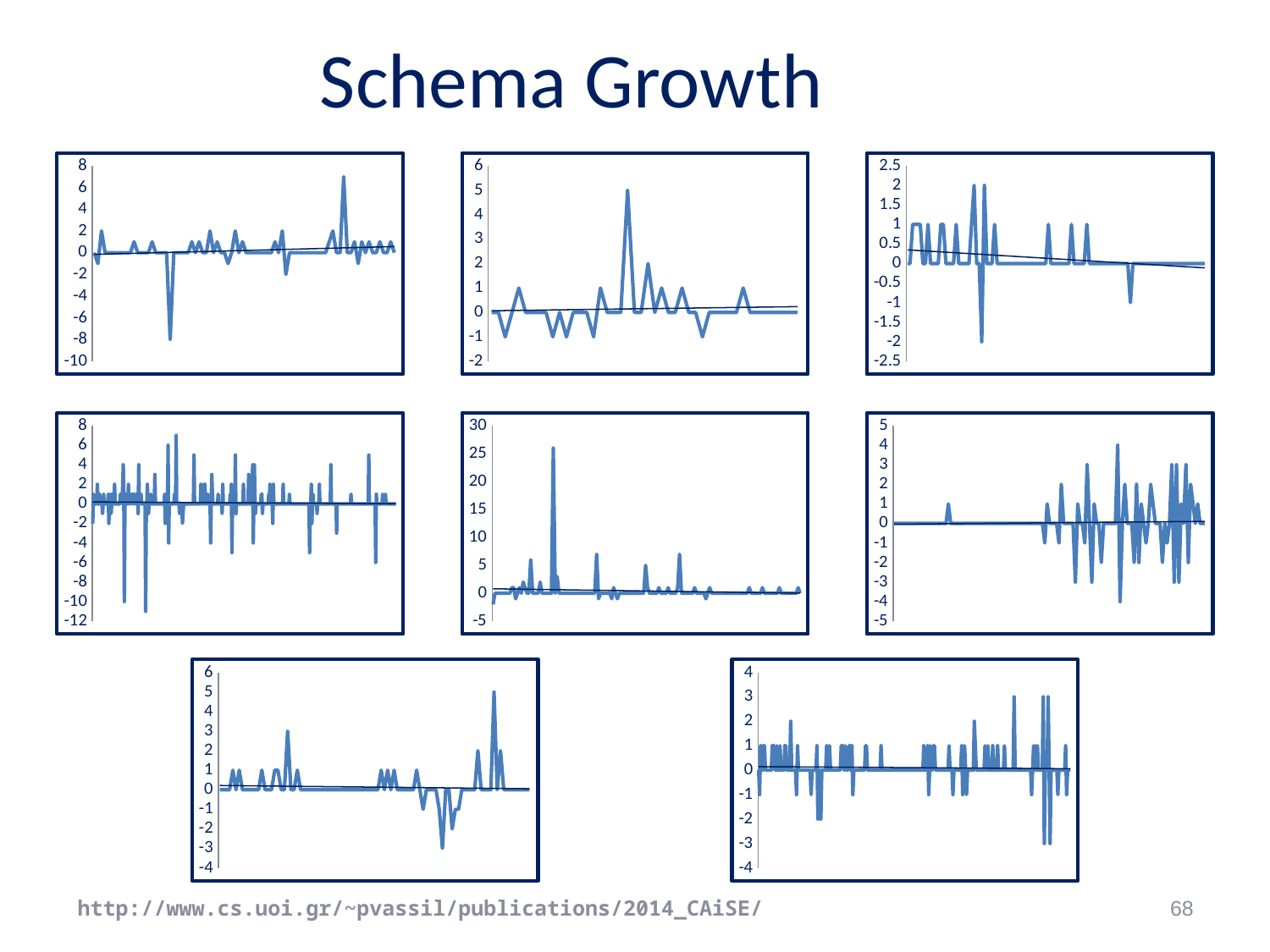
What kind of chart is the top-left chart on the slide? line chart In the middle chart of the second row, is the highest peak greater or less than 20? greater What is the title of the slide containing the charts? Schema Growth How many charts are shown on the slide? 8 In the top-middle chart, is the highest peak greater or less than 4? greater In the left chart of the second row, is the lowest value greater or less than -8? less In the top-right chart, does the thin trend line rise or fall from left to right? fall What is the highest value shown on the vertical axis of the middle chart in the second row? 30